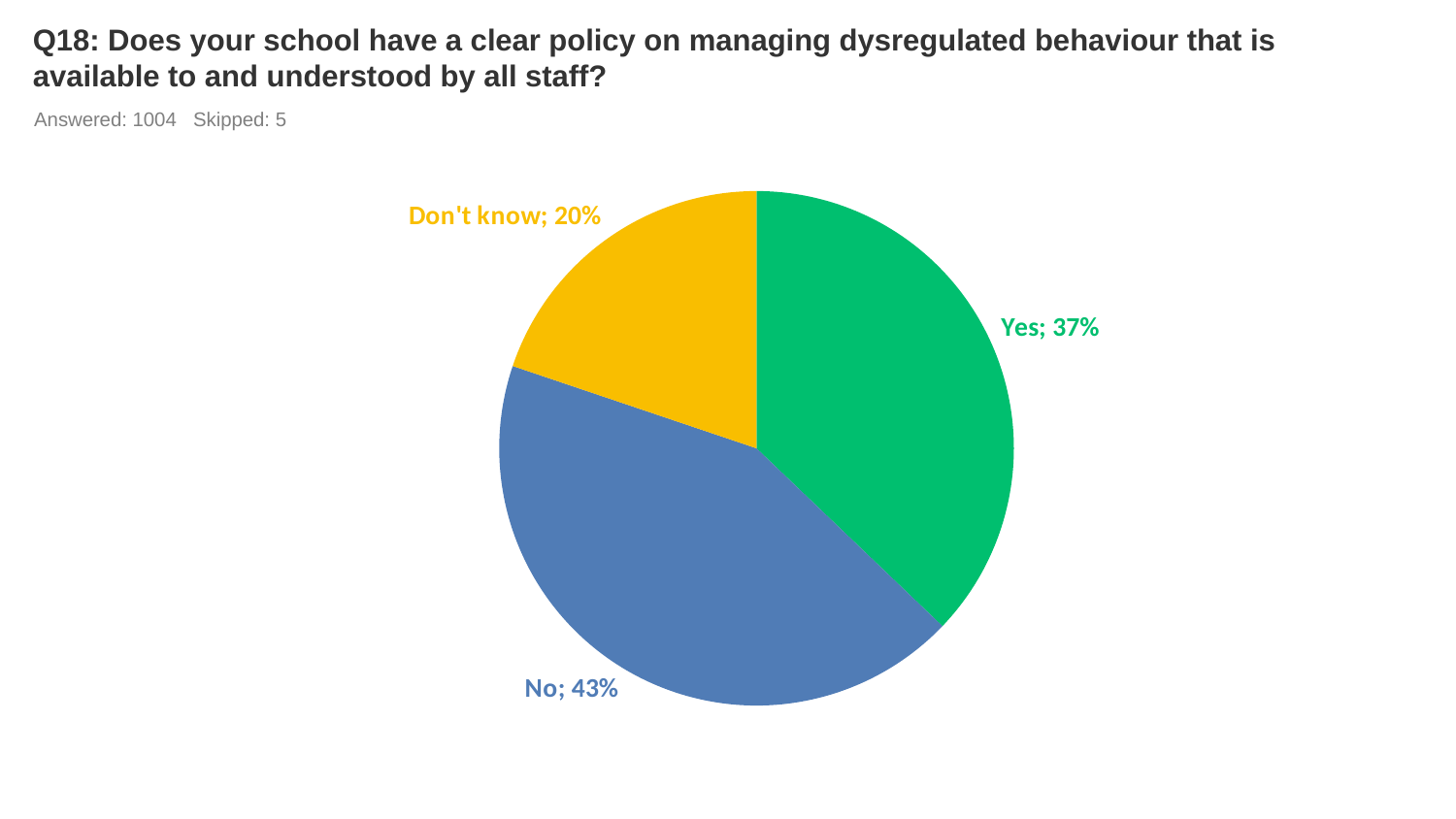
What percentage of respondents answered "Yes"? 37% What kind of chart is shown on the slide? Pie chart Which response has the largest share of the pie? No What colour is the "No" slice? Blue What percentage of respondents answered "No"? 43% Which response has the smallest share of the pie? Don't know How many slices does the pie chart have? 3 What is the difference in percentage points between the "No" and "Yes" slices? 6 How many respondents answered the question according to the slide? 1004 What is the difference in percentage points between the "Yes" and "Don't know" slices? 17 Which is larger, the "Yes" slice or the "Don't know" slice? Yes What percentage of respondents answered "Don't know"? 20%